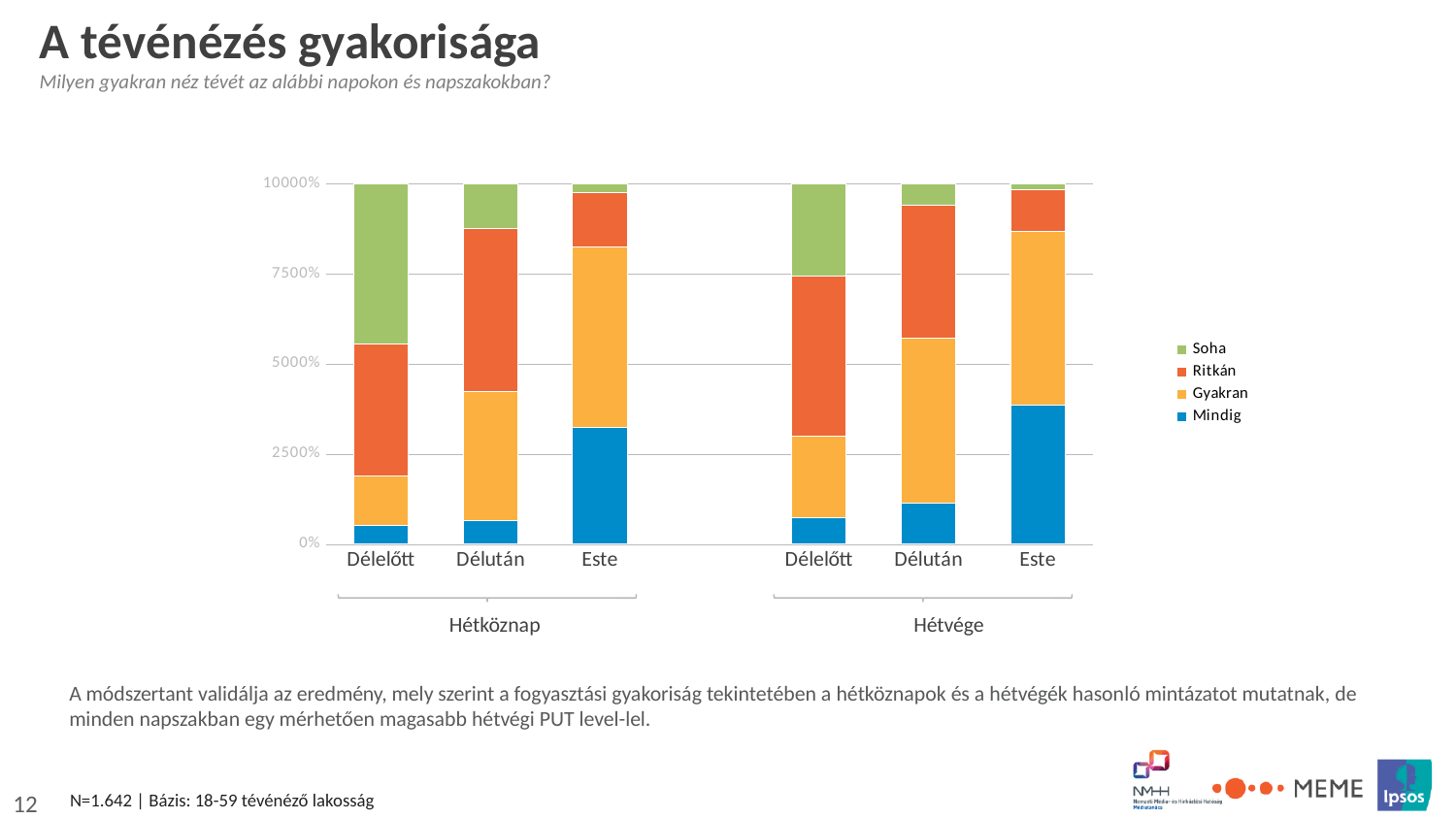
Within the Hétvége group, does the Soha segment rise or fall from Délelőtt to Este? fall How many bars are plotted in the chart? 6 Is the Mindig segment for Délelőtt under Hétköznap greater or less than 2500%? less Which legend entry is shown in green? Soha How many series does the legend list? 4 Within the Hétköznap group, does the Mindig segment rise or fall from Délelőtt to Este? rise Which category has the largest Soha (green) segment? Délelőtt (Hétköznap) What kind of chart is shown on the slide? stacked bar chart What is the title of the chart slide? A tévénézés gyakorisága Is the Mindig segment larger for Este under Hétvége or for Este under Hétköznap? Este under Hétvége Which category has the largest Mindig (blue) segment? Este (Hétvége) Is the Mindig segment for Este under Hétköznap greater or less than 2500%? greater